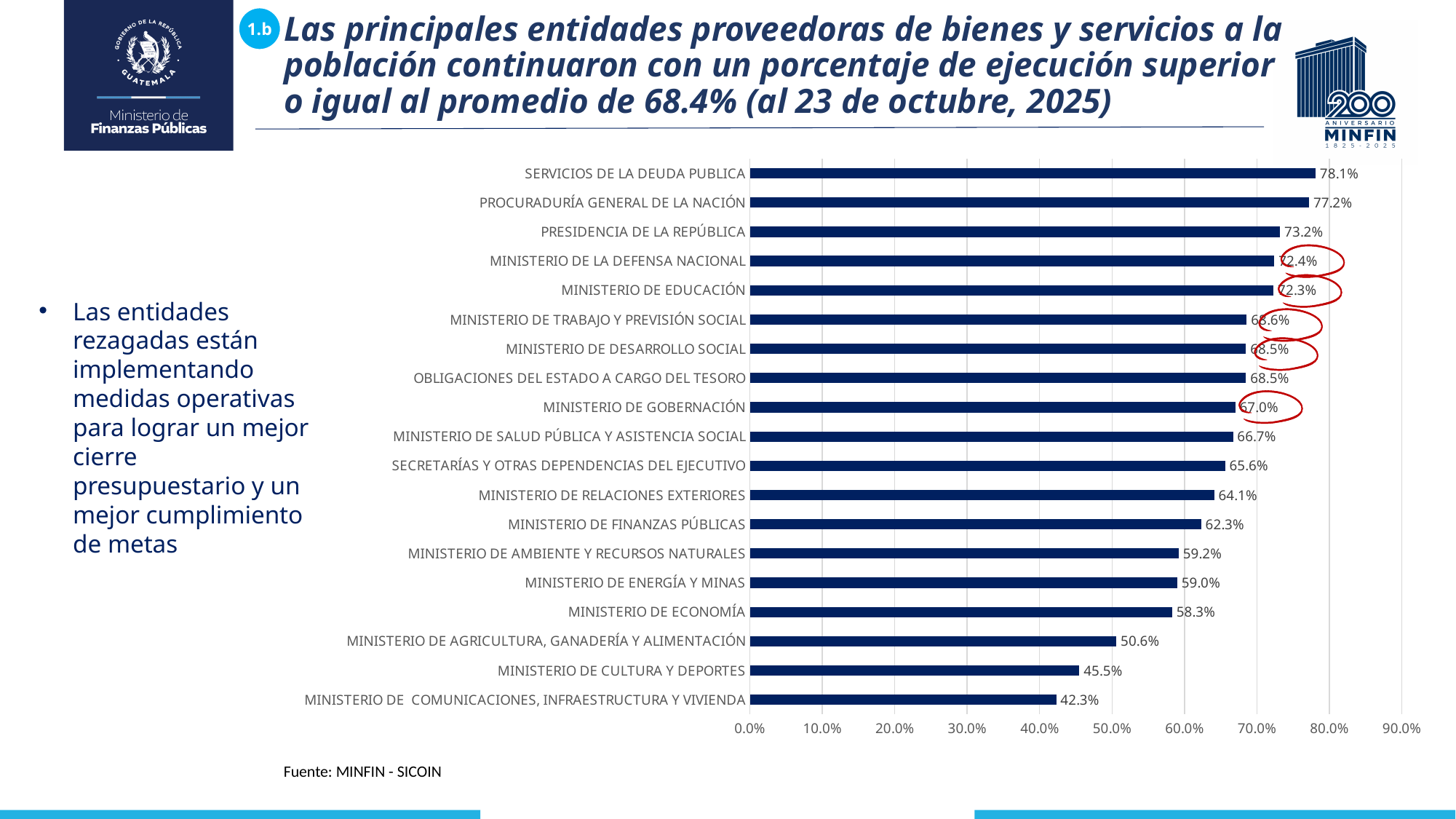
Which category has the highest value? SERVICIOS DE LA DEUDA PUBLICA Which category has the lowest value? MINISTERIO DE COMUNICACIONES, INFRAESTRUCTURA Y VIVIENDA What is the source cited below the chart? Fuente: MINFIN - SICOIN What is the value for MINISTERIO DE CULTURA Y DEPORTES? 45.5% Is the value for MINISTERIO DE RELACIONES EXTERIORES greater or less than 60.0%? greater Which is larger, the value for PRESIDENCIA DE LA REPÚBLICA or the value for MINISTERIO DE ECONOMÍA? PRESIDENCIA DE LA REPÚBLICA What is the difference between the values for SERVICIOS DE LA DEUDA PUBLICA and MINISTERIO DE COMUNICACIONES, INFRAESTRUCTURA Y VIVIENDA? 35.8% What is the value for SERVICIOS DE LA DEUDA PUBLICA? 78.1% What is the value for MINISTERIO DE FINANZAS PÚBLICAS? 62.3% What kind of chart is shown on the slide? bar chart What is the value for MINISTERIO DE AGRICULTURA, GANADERÍA Y ALIMENTACIÓN? 50.6% How many categories are shown in the chart? 19